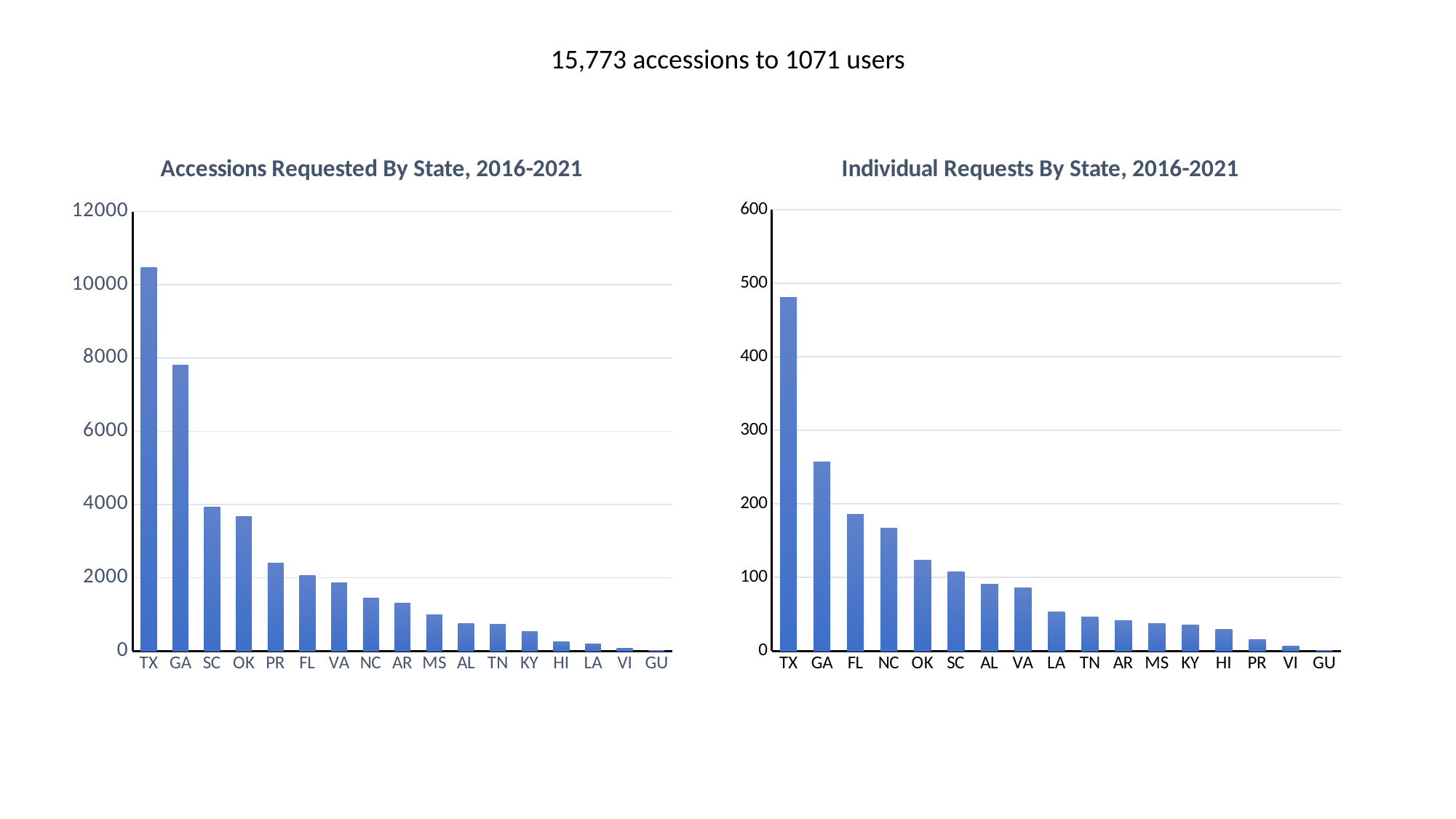
In the 'Accessions Requested By State, 2016-2021' chart, is the value for PR greater or less than 2000? greater In the 'Individual Requests By State, 2016-2021' chart, which state has the lowest value? GU In the 'Accessions Requested By State, 2016-2021' chart, which state has the highest value? TX In the 'Accessions Requested By State, 2016-2021' chart, is the value for TX greater or less than 10000? greater In the 'Accessions Requested By State, 2016-2021' chart, do the values rise or fall from left to right along the x axis? fall How many states are shown in the 'Accessions Requested By State, 2016-2021' chart? 17 In the 'Accessions Requested By State, 2016-2021' chart, which state has the lowest value? GU In the 'Individual Requests By State, 2016-2021' chart, which is larger, the value for FL or the value for NC? FL What kind of chart is the 'Individual Requests By State, 2016-2021' chart? Bar chart In the 'Individual Requests By State, 2016-2021' chart, is the value for GA greater or less than 200? greater In the 'Individual Requests By State, 2016-2021' chart, which state has the highest value? TX